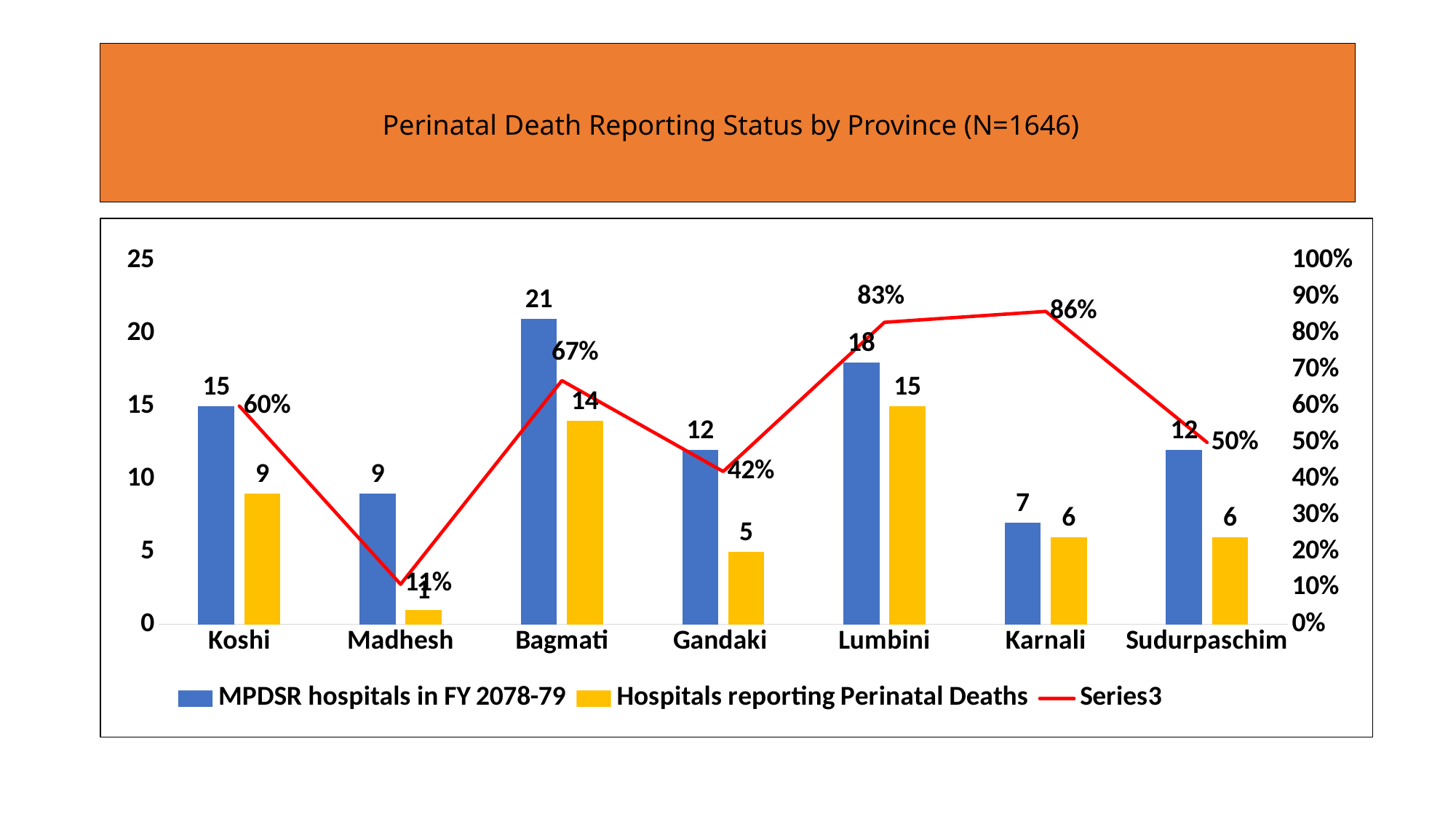
How many series does the legend list? 3 Which province has the highest number of MPDSR hospitals in FY 2078-79? Bagmati What is the Series3 value for Karnali? 86% How many MPDSR hospitals in FY 2078-79 are shown for Bagmati? 21 How many hospitals reporting Perinatal Deaths are shown for Lumbini? 15 Which is larger: the number of hospitals reporting Perinatal Deaths in Koshi or in Karnali? Koshi What is the difference between the number of MPDSR hospitals in FY 2078-79 and the number of hospitals reporting Perinatal Deaths in Gandaki? 7 Which province has the lowest number of hospitals reporting Perinatal Deaths? Madhesh Is the Series3 value for Madhesh greater or less than 20%? less How many provinces are shown on the x axis? 7 What is the title of the chart? Perinatal Death Reporting Status by Province (N=1646) What kind of chart is shown on the slide? Combined bar and line chart